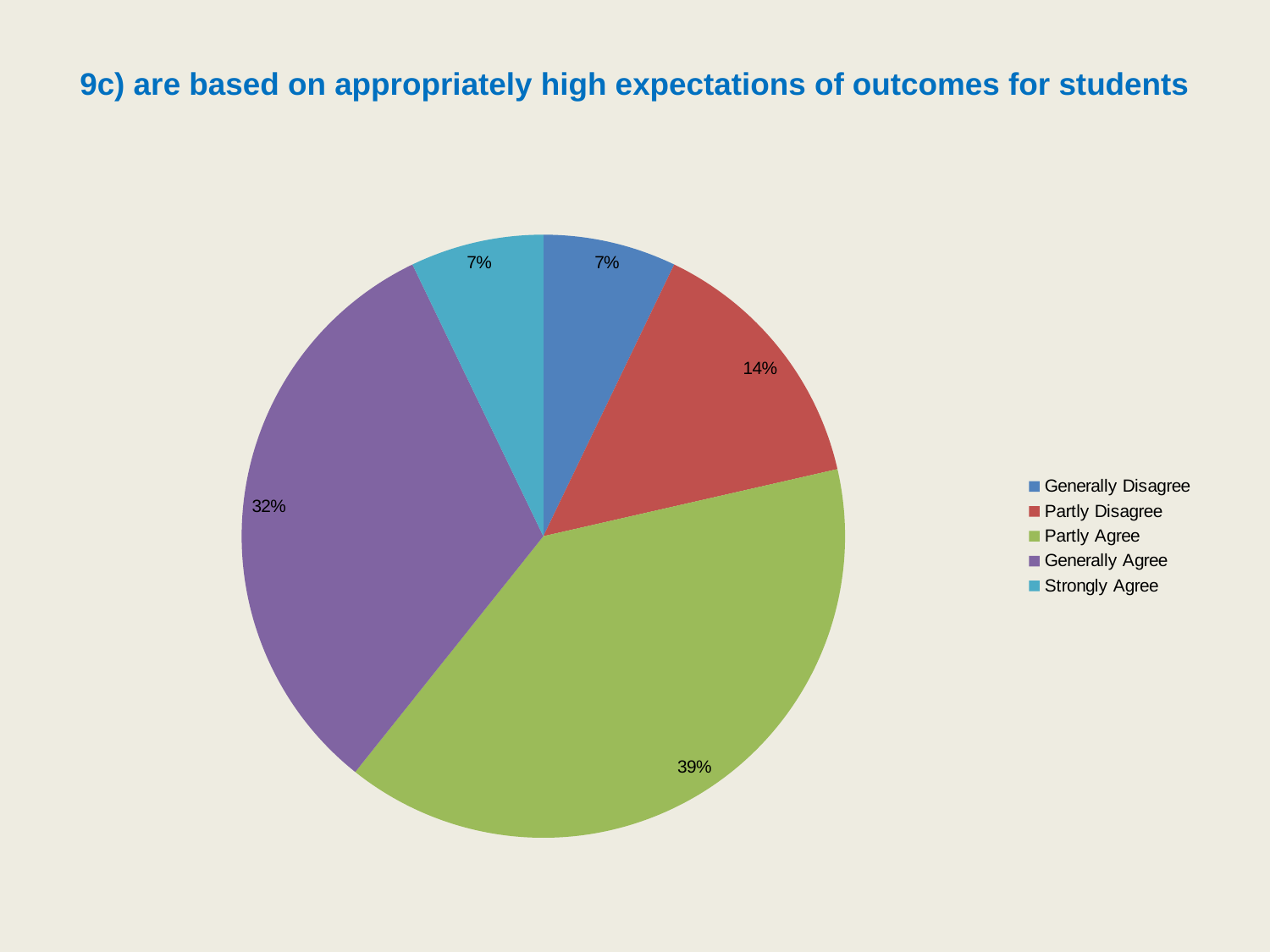
What colour is the Generally Agree slice? purple What percentage of respondents chose Strongly Agree? 7% What percentage of respondents chose Partly Agree? 39% How many categories does the legend list? 5 What is the title of the chart? 9c) are based on appropriately high expectations of outcomes for students What percentage of respondents chose Partly Disagree? 14% What percentage of respondents chose Generally Agree? 32% Which is larger, the share for Partly Disagree or the share for Strongly Agree? Partly Disagree Which response category has the largest share of the pie? Partly Agree What is the difference in percentage points between Partly Agree and Generally Agree? 7 What kind of chart is shown on the slide? pie chart What is the difference in percentage points between Partly Disagree and Generally Disagree? 7